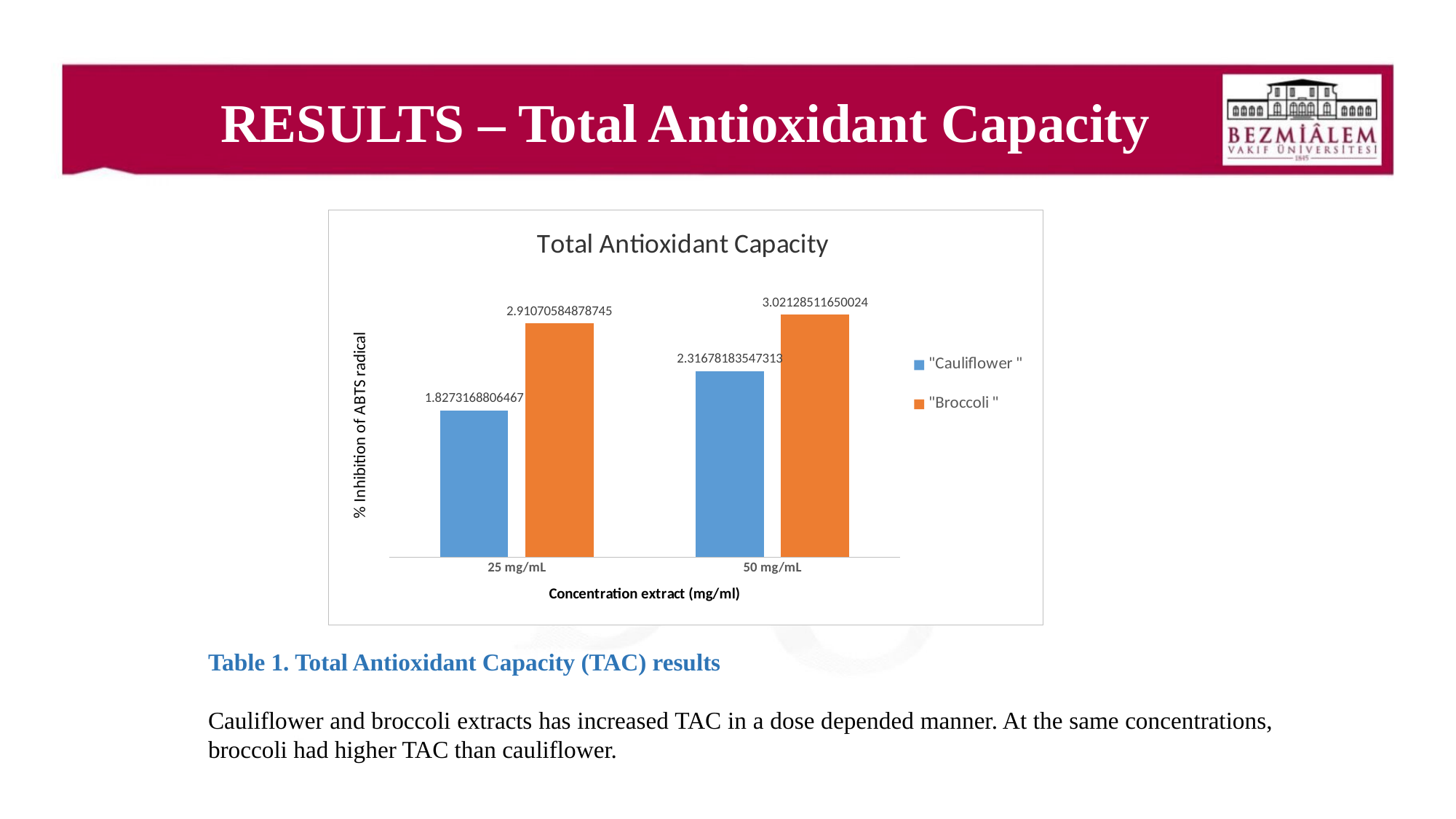
At 50 mg/mL, which is larger, Cauliflower or Broccoli? Broccoli How many series does the legend list? 2 What is the value for Broccoli at 25 mg/mL? 2.91070584878745 What is the value for Cauliflower at 25 mg/mL? 1.8273168806467 What is the difference between Broccoli and Cauliflower at 50 mg/mL? 0.70450328102711 Does the Cauliflower value rise or fall from 25 mg/mL to 50 mg/mL? Rise What is the value for Cauliflower at 50 mg/mL? 2.31678183547313 Which bar has the highest value in the chart? Broccoli at 50 mg/mL How many concentration categories are shown on the x axis? 2 What is the value for Broccoli at 50 mg/mL? 3.02128511650024 What kind of chart is shown on the slide? Bar chart Which bar has the lowest value in the chart? Cauliflower at 25 mg/mL